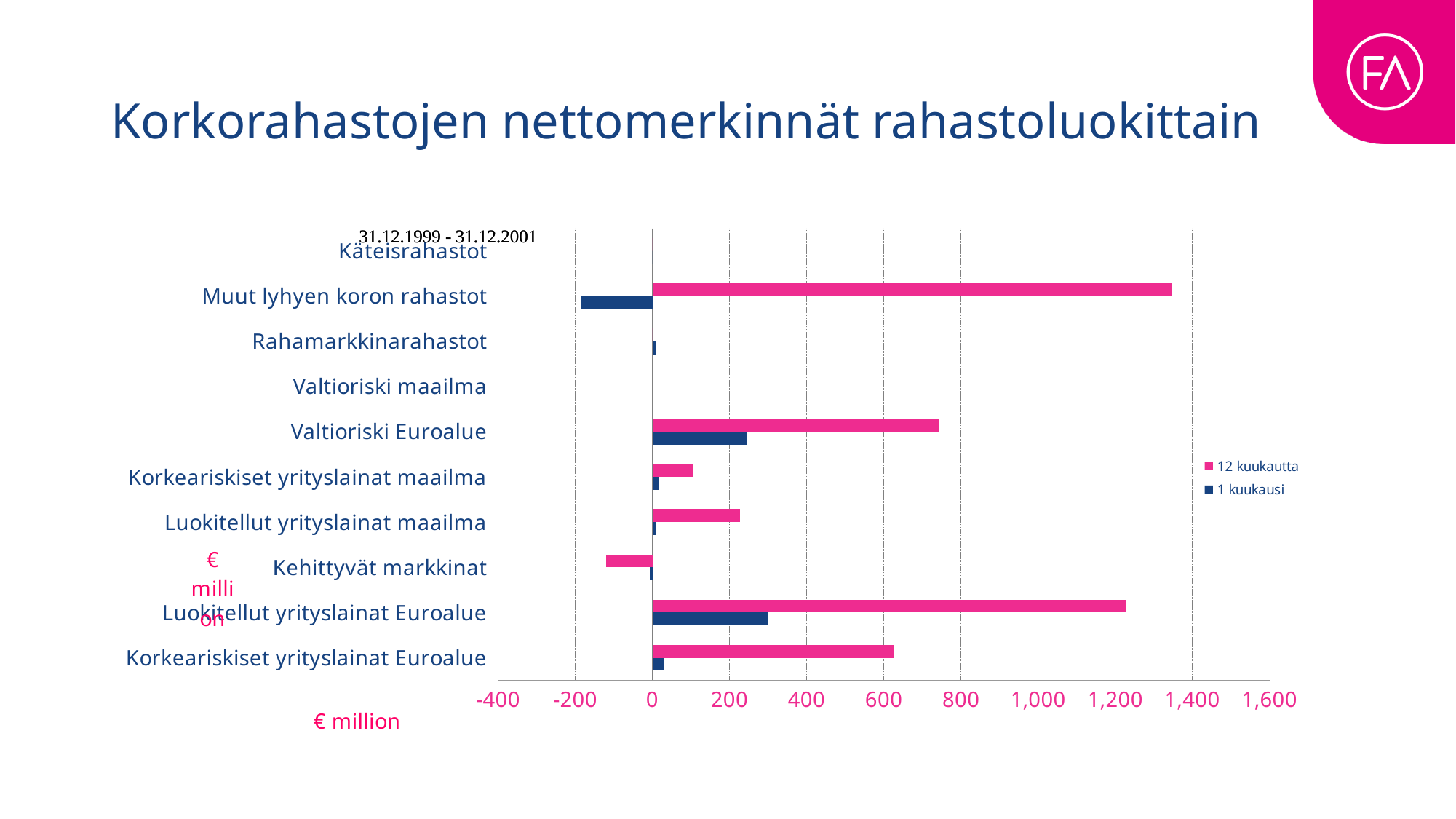
How many series does the legend list? 2 Which category has the highest value for the 12 kuukautta series? Muut lyhyen koron rahastot Is the 12 kuukautta value for Muut lyhyen koron rahastot greater or less than 1,200? greater What unit label is shown below the horizontal axis? € million Is the 12 kuukautta value for Korkeariskiset yrityslainat Euroalue greater or less than 800? less Is the 1 kuukausi value for Luokitellut yrityslainat Euroalue greater or less than 200? greater Which category has the lowest value for the 1 kuukausi series? Muut lyhyen koron rahastot For the 12 kuukautta series, which is larger: Valtioriski Euroalue or Korkeariskiset yrityslainat Euroalue? Valtioriski Euroalue What kind of chart is shown on the slide? bar chart Which category has the lowest value for the 12 kuukautta series? Kehittyvät markkinat How many fund categories are listed on the vertical axis? 10 Which category has the highest value for the 1 kuukausi series? Luokitellut yrityslainat Euroalue